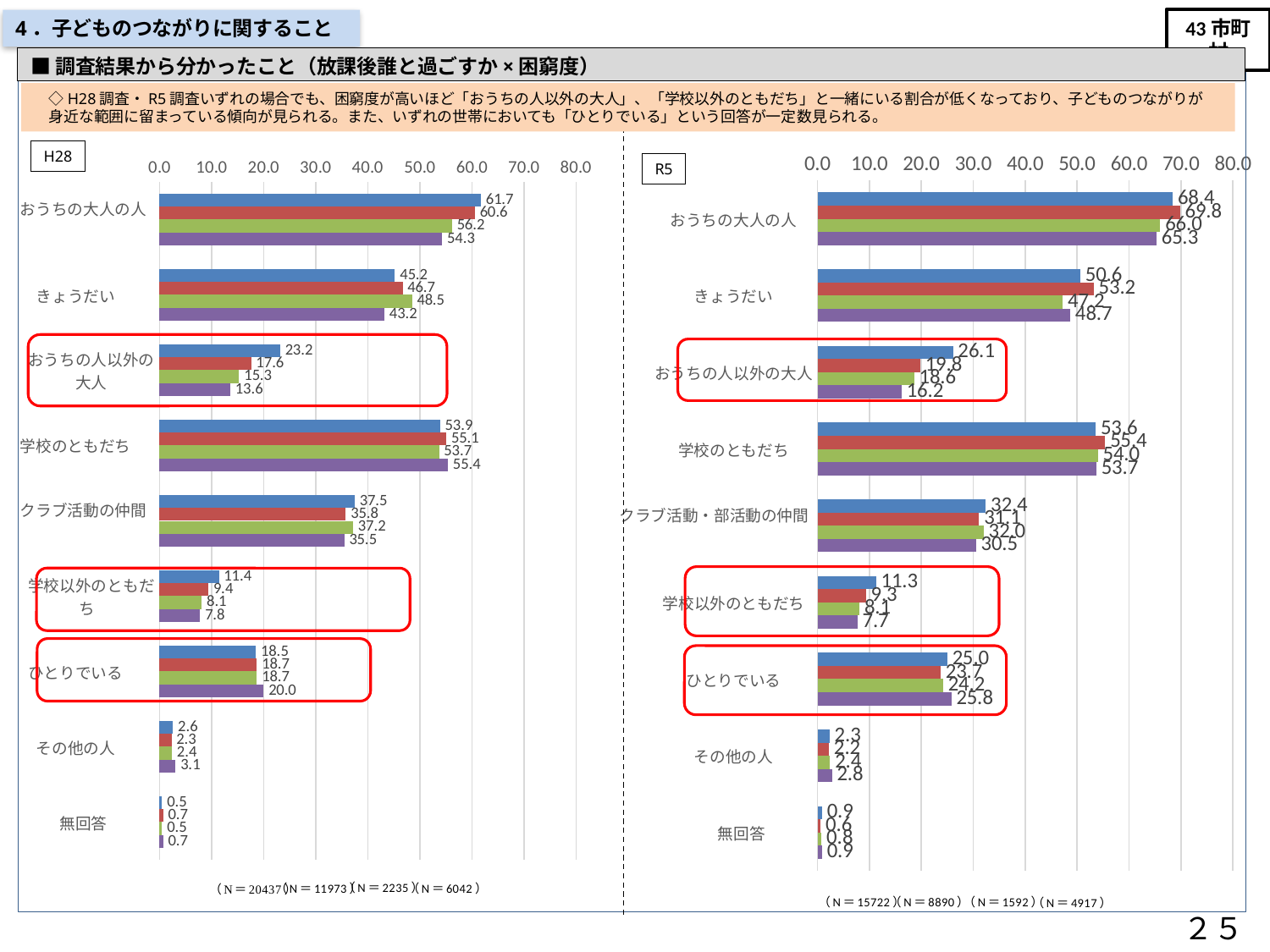
In the R5 chart, what is the value of the purple bar for ひとりでいる? 25.8 In the H28 chart, what is the value of the purple bar for 学校以外のともだち? 7.8 In the R5 chart, is the value of the blue bar for おうちの大人の人 greater or less than 60.0? greater In the R5 chart, what is the value of the red bar for おうちの大人の人? 69.8 In the H28 chart, which category has the highest value for the blue bar? おうちの大人の人 In the R5 chart, which is larger for きょうだい: the red bar or the green bar? the red bar In the R5 chart, which category has the lowest value for the blue bar? 無回答 In the H28 chart, what is the value of the blue bar for おうちの人以外の大人? 23.2 What kind of chart is the H28 chart on the left? bar chart In the H28 chart, what is the difference between the blue bar (23.2) and the purple bar (13.6) for おうちの人以外の大人? 9.6 What is the label shown in the box at the top left of the right-hand chart? R5 How many categories are shown on the R5 chart on the right? 9